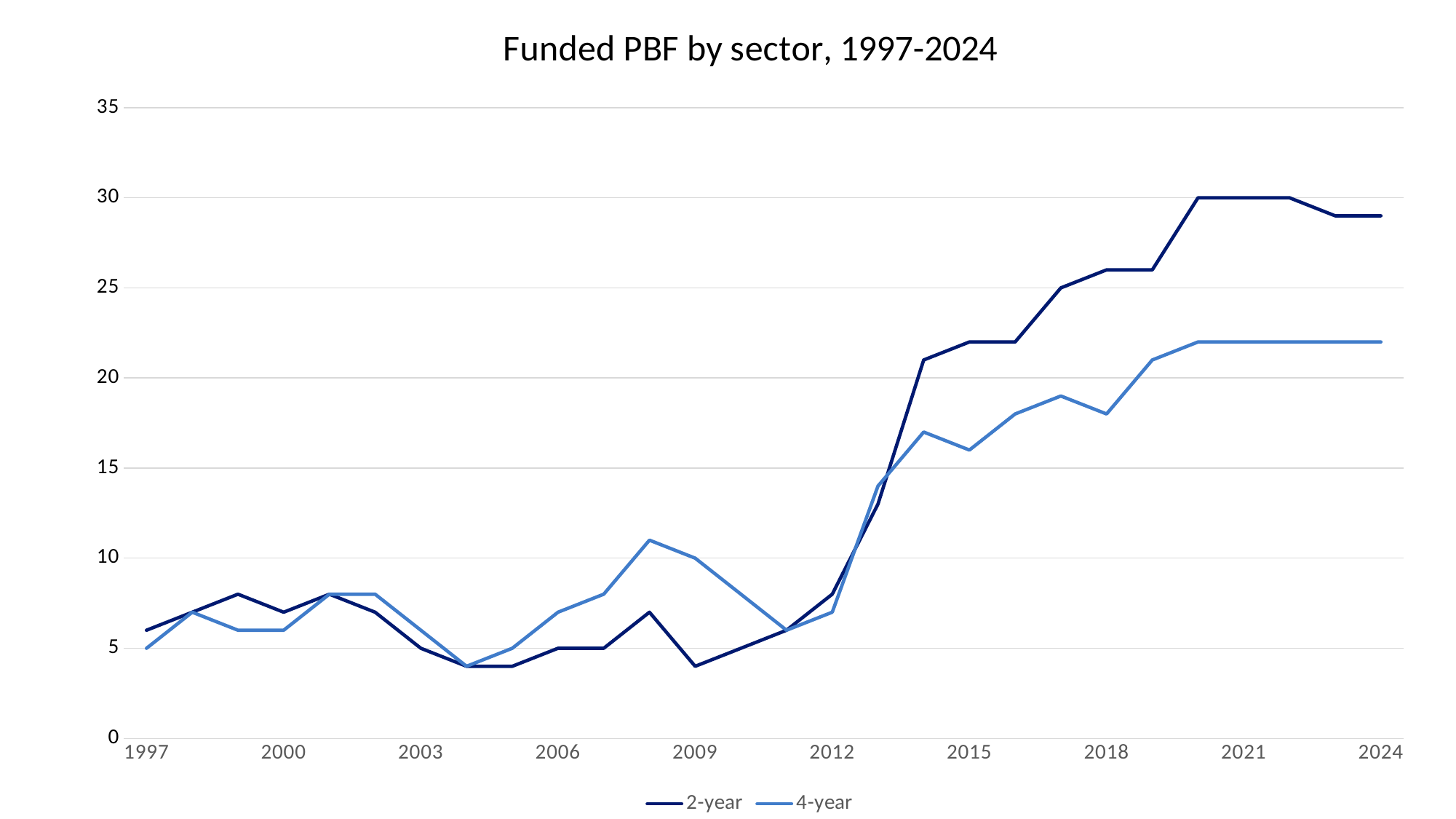
In 2008, which series has the higher value, 2-year or 4-year? 4-year What is the title of the chart? Funded PBF by sector, 1997-2024 How many series does the legend list? 2 Is the value for the 2-year series in 2013 greater or less than 15? less In 2024, which series has the higher value, 2-year or 4-year? 2-year Overall, do the values for the 2-year series rise or fall from 1997 to 2024? rise What is the value for the 4-year series in 2009? 10 Is the value for the 4-year series in 2024 greater or less than 20? greater What is the value for the 2-year series in 2017? 25 What is the value for the 4-year series in 1997? 5 What is the value for the 2-year series in 2020? 30 What kind of chart is shown on the slide? line chart